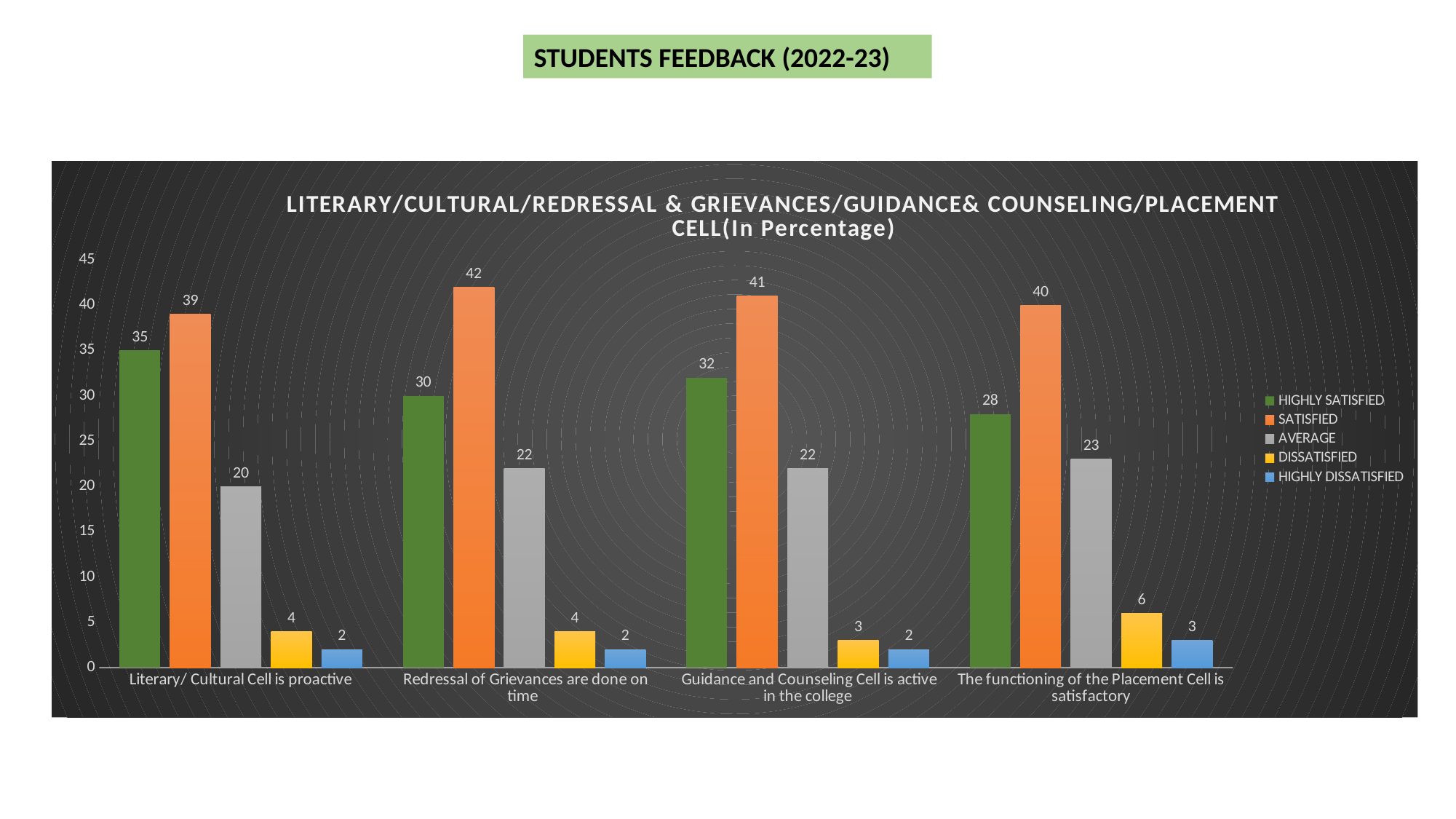
Which category has the lowest HIGHLY SATISFIED value? The functioning of the Placement Cell is satisfactory What is the DISSATISFIED value for 'Guidance and Counseling Cell is active in the college'? 3 How many series does the legend list? 5 Which category has the highest SATISFIED value? Redressal of Grievances are done on time What is the HIGHLY SATISFIED value for 'Literary/ Cultural Cell is proactive'? 35 Which legend entry is shown in orange? SATISFIED What is the difference between the SATISFIED and HIGHLY SATISFIED values for 'Guidance and Counseling Cell is active in the college'? 9 What kind of chart is shown on the slide? Bar chart Which is larger: the DISSATISFIED value for 'The functioning of the Placement Cell is satisfactory' or for 'Literary/ Cultural Cell is proactive'? The functioning of the Placement Cell is satisfactory How many categories are shown on the x axis? 4 What is the AVERAGE value for 'The functioning of the Placement Cell is satisfactory'? 23 What is the SATISFIED value for 'Redressal of Grievances are done on time'? 42